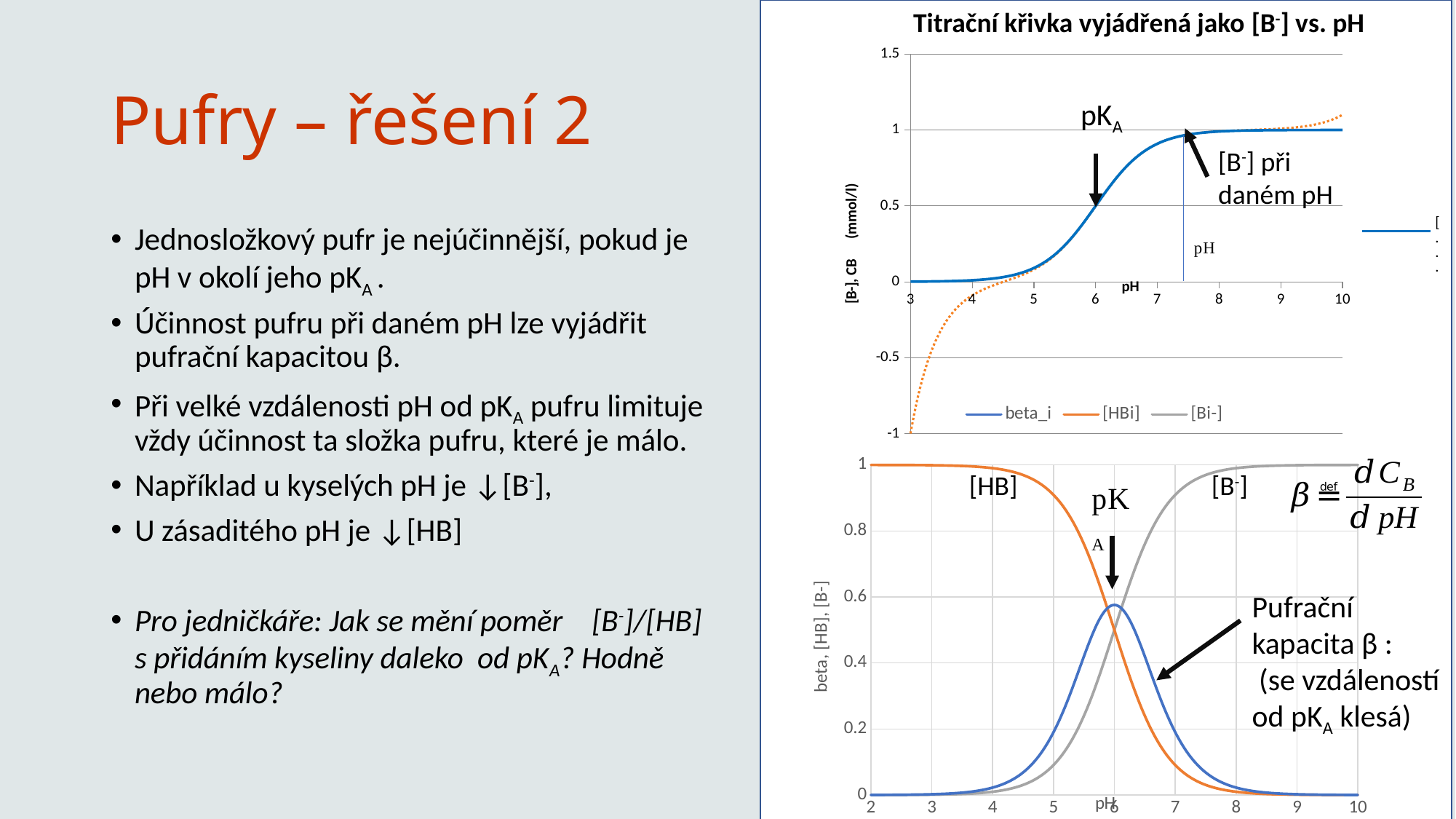
In the top chart, is the value of the solid blue curve at pH 4 greater or less than 0.5? less In the top chart, is the value of the solid blue curve at pH 9 greater or less than 0.5? greater In the top chart, does the solid blue [B-] curve rise or fall as pH increases from 3 to 10? rises In the bottom chart, is the peak value of the blue beta curve greater or less than 0.4? greater How many series does the legend between the two charts list? 3 In the bottom chart, at pH 4, which curve has the larger value: [HB] or [B-]? [HB] What kind of chart is the top chart titled "Titrační křivka vyjádřená jako [B-] vs. pH"? line chart In the bottom chart, does the orange [HB] curve rise or fall as pH increases? falls In the bottom chart, at pH 8, which curve has the larger value: [HB] or [B-]? [B-] What is the title of the top chart on the slide? Titrační křivka vyjádřená jako [B-] vs. pH